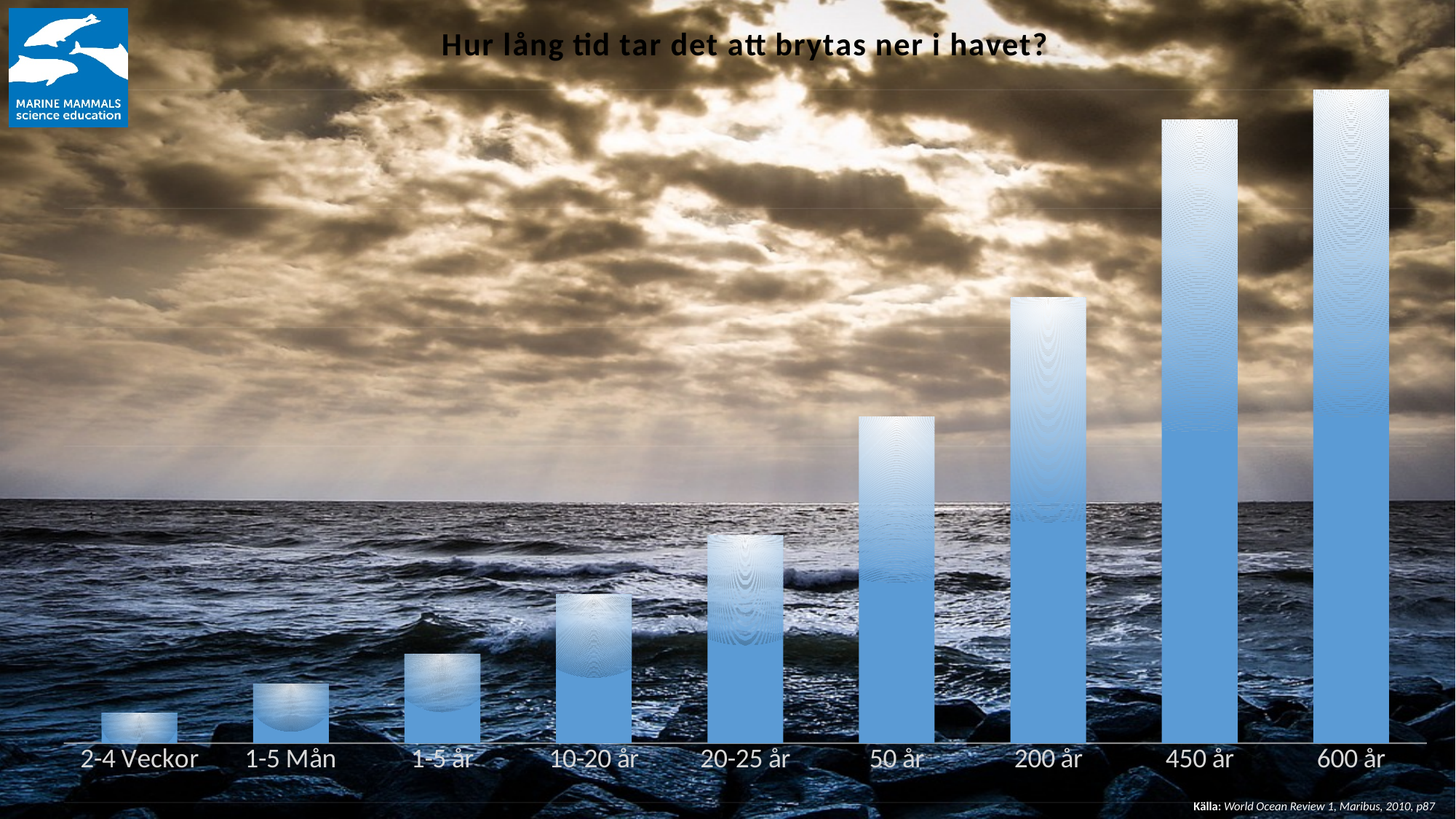
Do the bars rise or fall from left to right along the x axis? rise How many categories (bars) does the chart show? 9 What is the title of the chart? Hur lång tid tar det att brytas ner i havet? Which bar is taller, the one for 50 år or the one for 200 år? 200 år Which bar is shorter, the one for 450 år or the one for 20-25 år? 20-25 år What kind of chart is shown on the slide? bar chart Which category has the shortest bar? 2-4 Veckor What is the label of the first category on the left of the x axis? 2-4 Veckor Which bar is taller, the one for 1-5 Mån or the one for 10-20 år? 10-20 år Which category has the tallest bar? 600 år